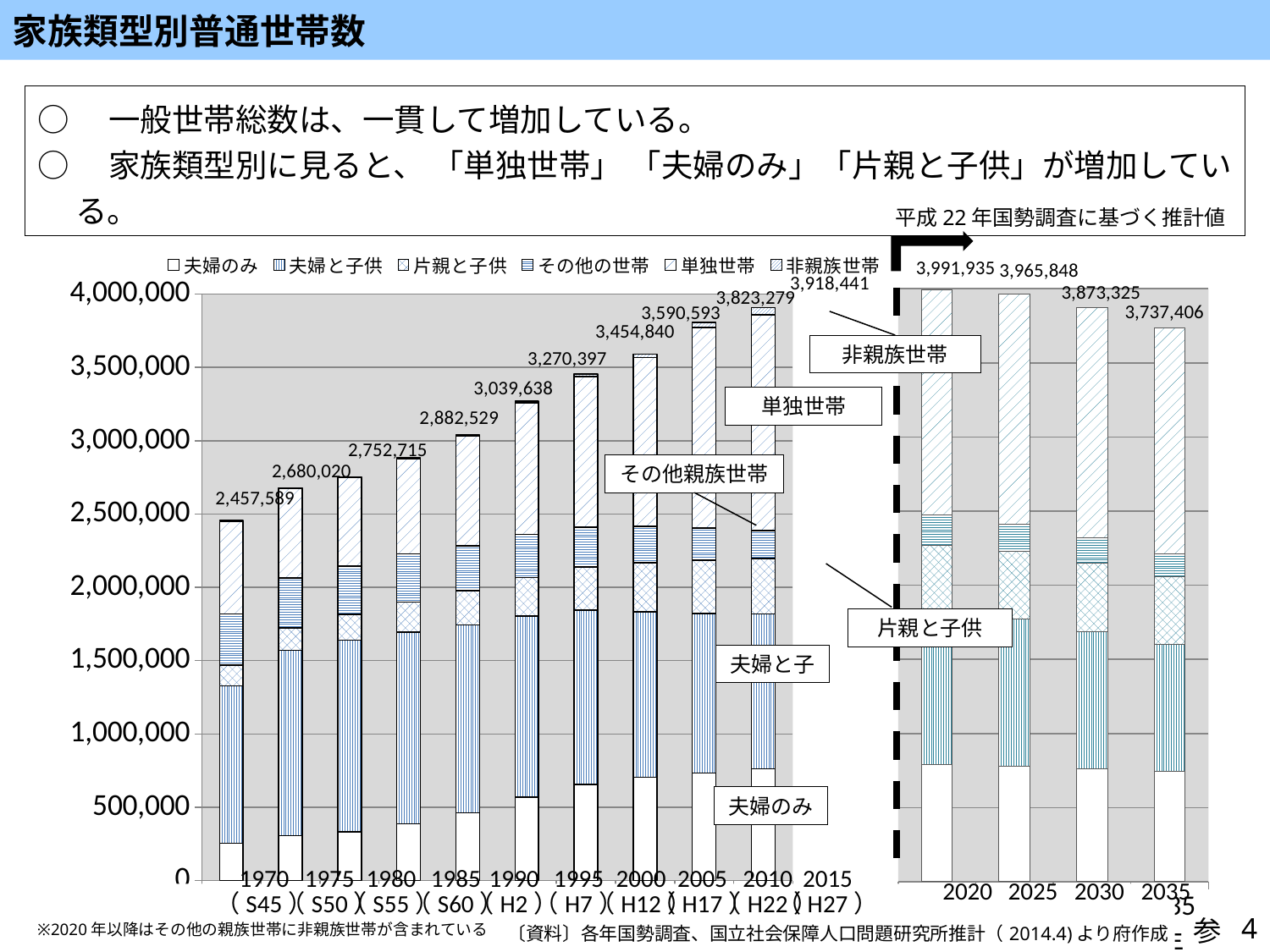
What is the title of the chart slide? 家族類型別普通世帯数 What is the total number of households shown for 2035? 3,737,406 Which is larger, the total for 2025 or the total for 2030? 2025 What kind of chart is shown on the slide? bar chart What is the total number of households shown for 2020? 3,991,935 What is the lowest total number of households labelled in the chart? 2,457,589 Which year has the highest total number of households in the chart? 2020 How many series does the chart legend list? 6 Do the total household numbers rise or fall from 2020 to 2035? fall What is the total number of households shown for 2030? 3,873,325 What is the difference between the total for 2020 and the total for 2035? 254,529 Is the total for 2035 greater or less than 3,500,000? greater